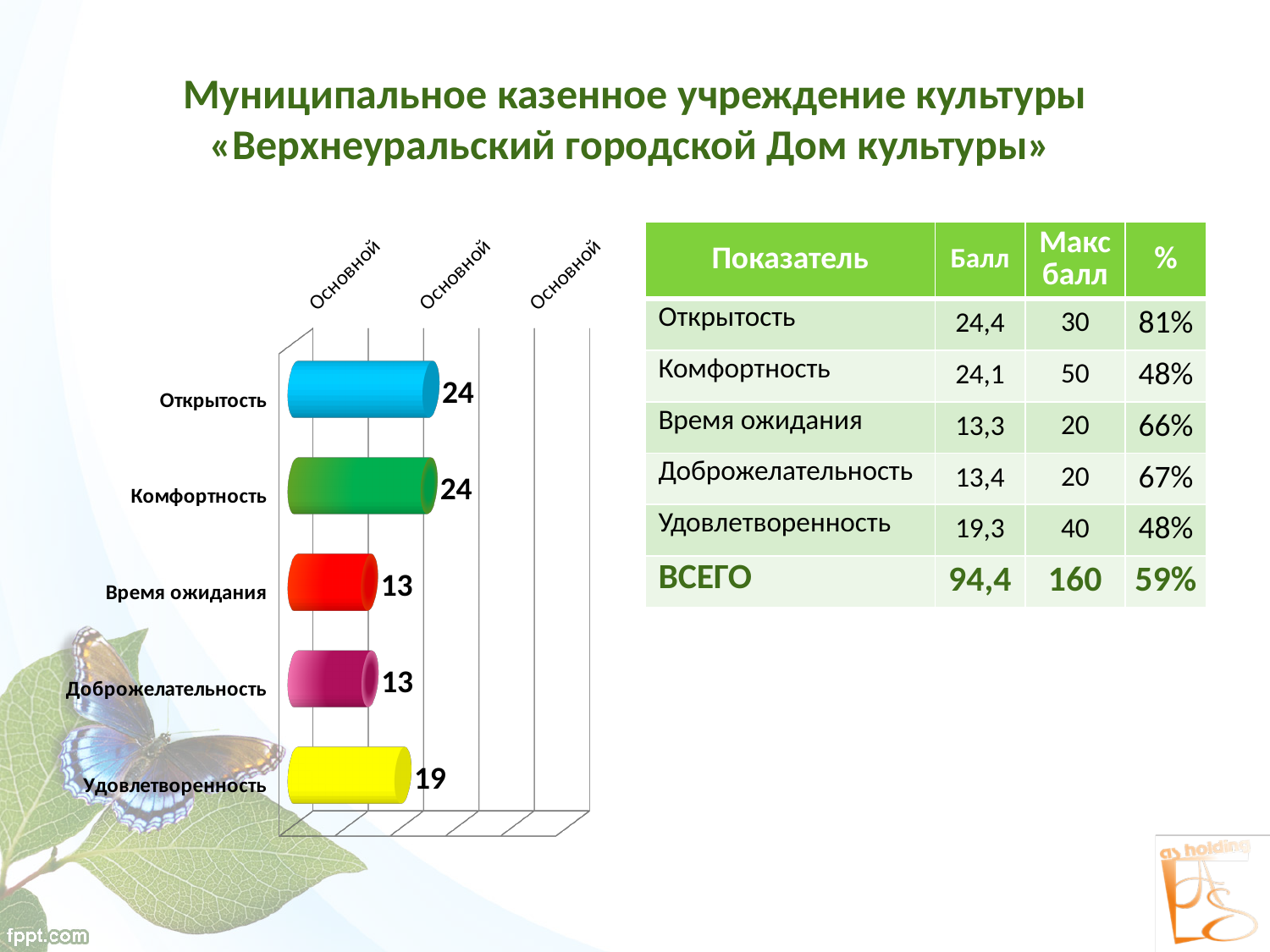
What value is shown for Удовлетворенность in the bar chart? 19 What value is shown for Доброжелательность in the bar chart? 13 Which has the larger value in the bar chart, Удовлетворенность or Время ожидания? Удовлетворенность How many categories are shown in the bar chart? 5 What colour is the bar for Удовлетворенность in the chart? Yellow What kind of chart is shown on the slide? Bar chart What is the difference between the values for Открытость and Удовлетворенность in the bar chart? 5 What value is shown for Время ожидания in the bar chart? 13 What value is shown for Комфортность in the bar chart? 24 What is the difference between the values for Удовлетворенность and Доброжелательность in the bar chart? 6 What is the difference between the values for Комфортность and Время ожидания in the bar chart? 11 What value is shown for Открытость in the bar chart? 24